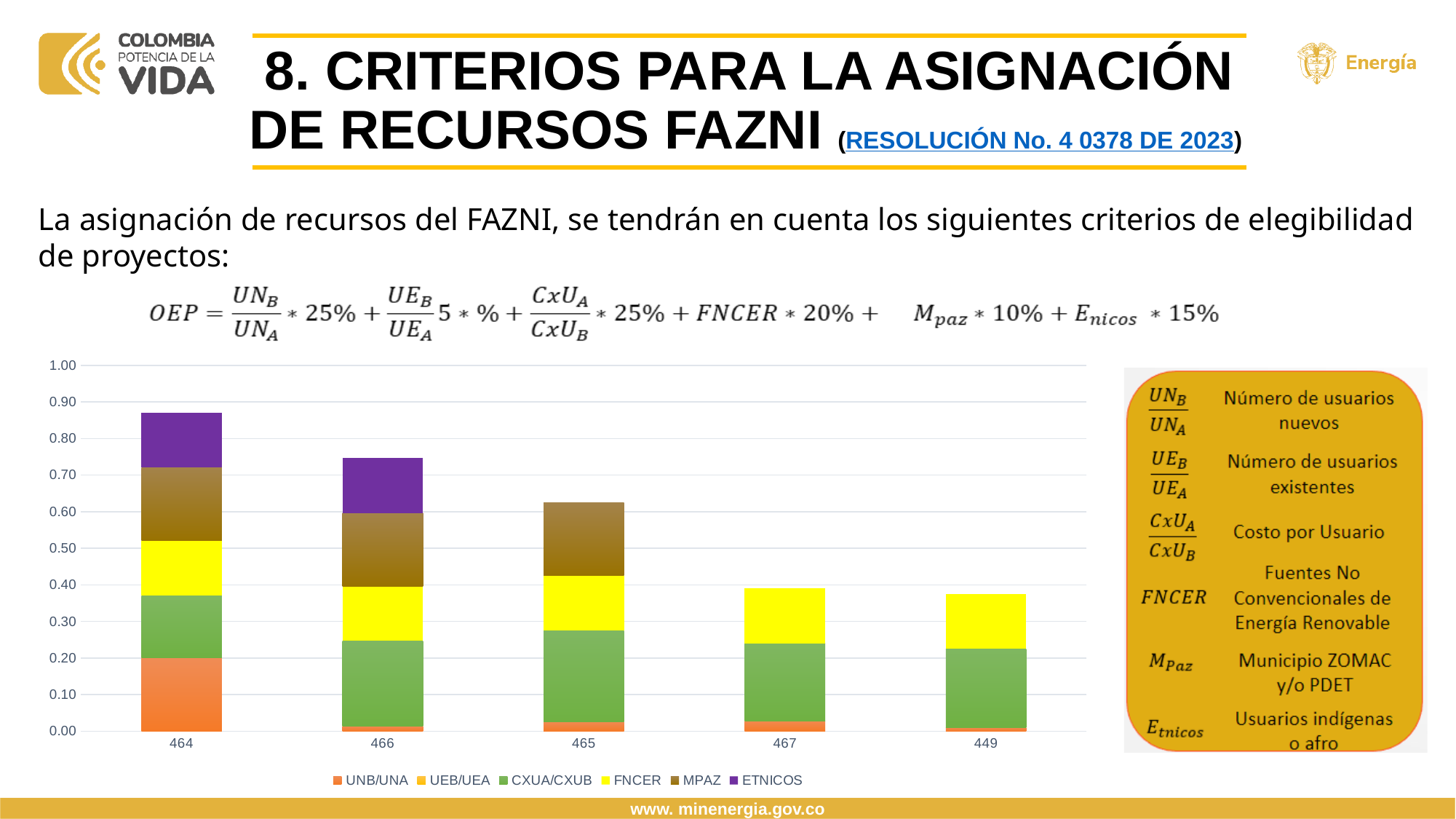
Which has the larger total stacked bar, category 466 or category 465? 466 Do the total stacked values generally rise or fall from left to right along the x axis? fall How many series does the chart legend list? 6 Which series is shown in yellow in the chart legend? FNCER Is the total stacked value for category 466 greater or less than 0.70? greater Which categories include an ETNICOS segment in their stacked bar? 464 and 466 Is the total stacked value for category 464 greater or less than 0.80? greater Is the total stacked value for category 465 greater or less than 0.70? less How many categories are shown on the x axis of the chart? 5 What kind of chart is shown on the slide? Stacked bar chart Which category has the highest total stacked bar? 464